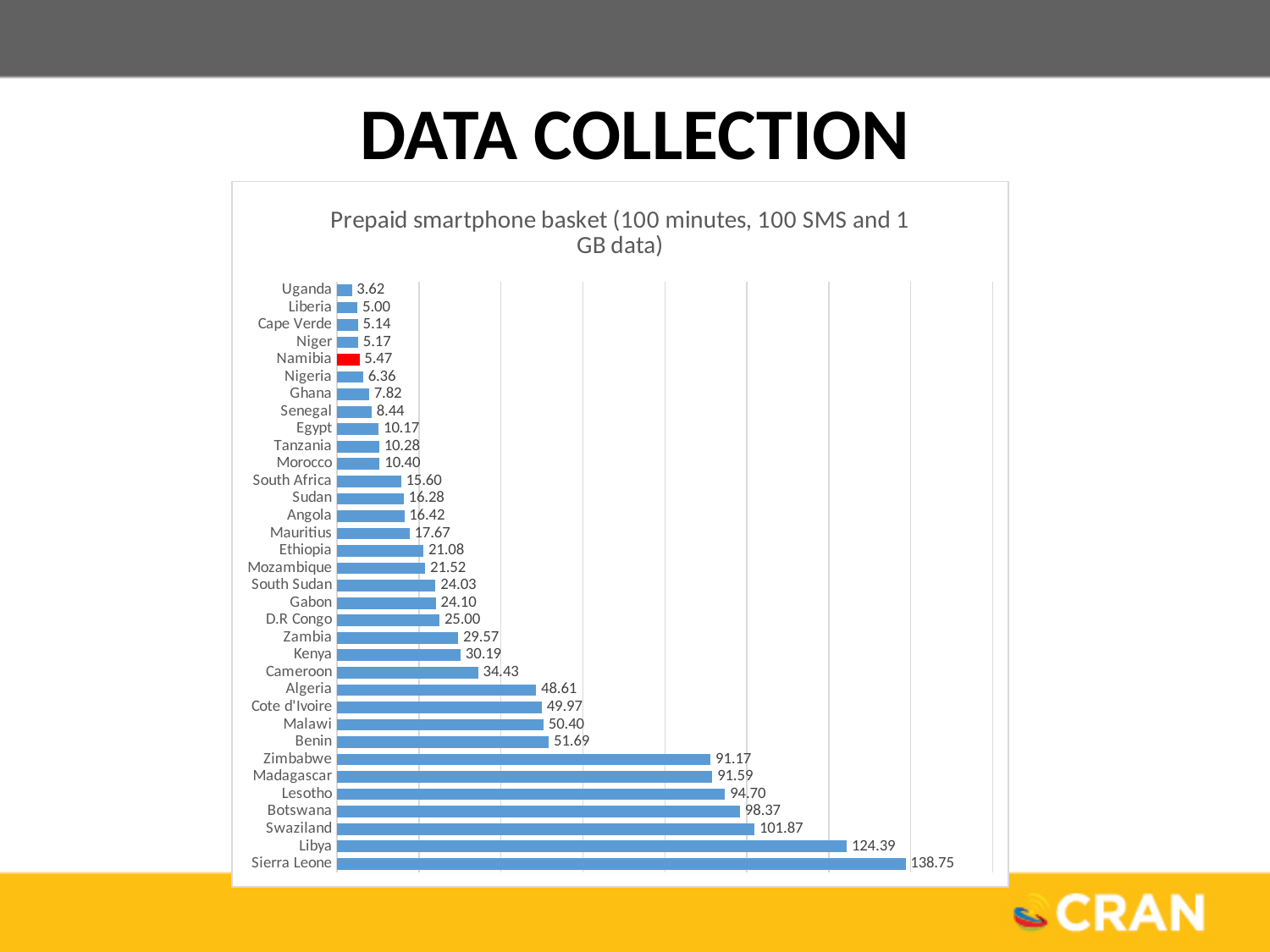
Which has a larger value, Cameroon or Algeria? Algeria What is the value for South Africa? 15.60 What is the value for Zimbabwe? 91.17 What is the difference between the values for Sierra Leone and Libya? 14.36 What is the value for Sierra Leone? 138.75 Which country has the highest value in the chart? Sierra Leone Which country's bar is coloured red instead of blue? Namibia Which country has the lowest value in the chart? Uganda What type of chart is shown on the slide? Bar chart What is the value for Namibia in the prepaid smartphone basket chart? 5.47 What is the difference between the values for Namibia and Uganda? 1.85 How many countries are shown in the chart? 34